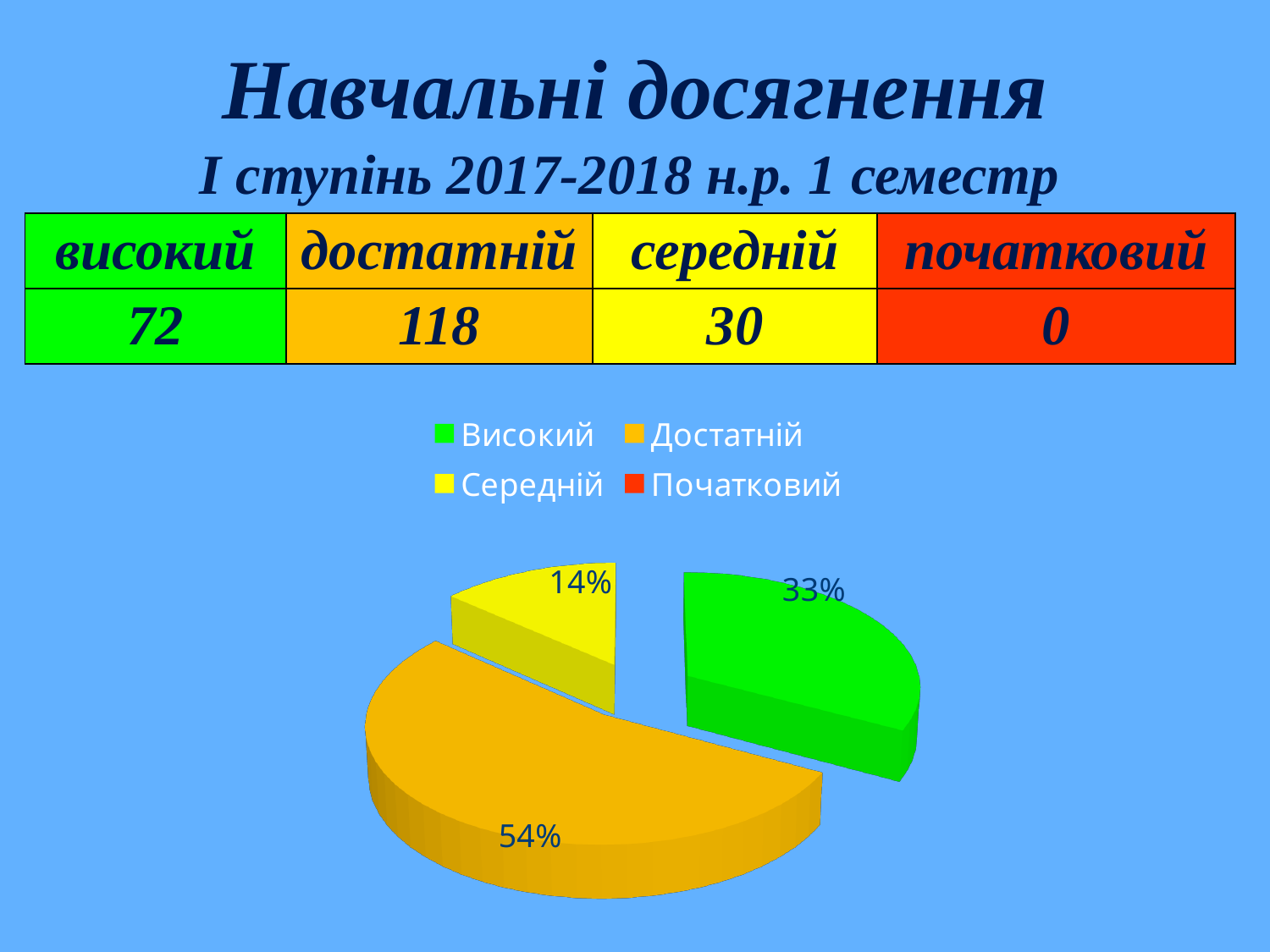
What kind of chart is shown on the slide? pie chart What share of the pie does the Високий slice have? 33% Which slice is larger, Високий or Середній? Високий Which category has the largest slice of the pie? Достатній What share of the pie does the Середній slice have? 14% Which legend entry has no visible slice in the pie chart? Початковий Which category with a visible slice has the smallest share of the pie? Середній By how many percentage points does the Достатній share exceed the Високий share? 21 What colour is the Достатній slice in the pie chart? orange By how many percentage points does the Достатній share exceed the Середній share? 40 How many entries does the chart legend list? 4 What share of the pie does the Достатній slice have? 54%